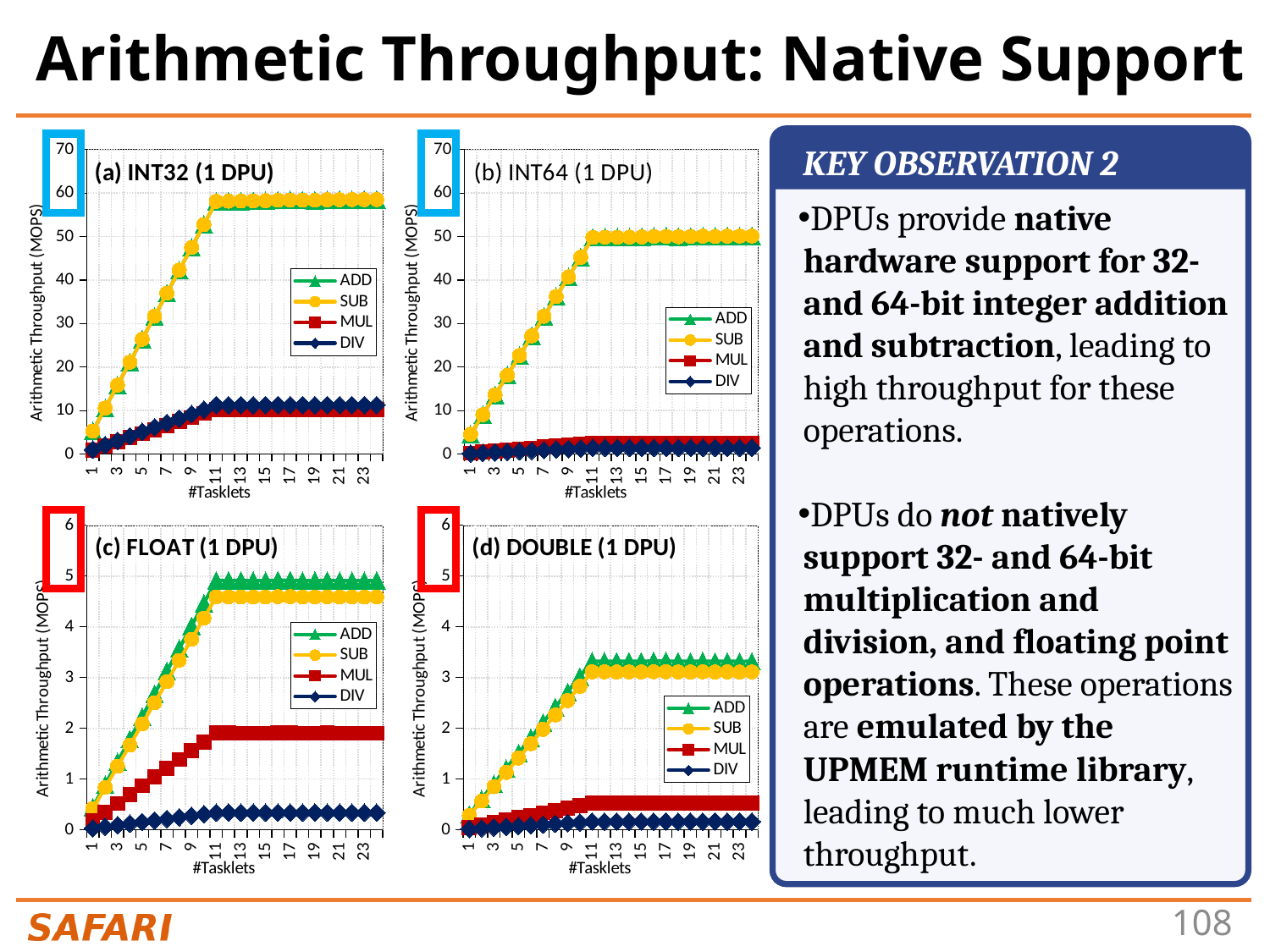
What kind of chart is chart (a) INT32 (1 DPU)? line chart In chart (c) FLOAT (1 DPU), which is larger at 23 tasklets, MUL or DIV? MUL In chart (b) INT64 (1 DPU), is the SUB throughput at 23 tasklets greater or less than 40? greater What is the x-axis label of chart (d) DOUBLE (1 DPU)? #Tasklets How many series does the legend of chart (b) INT64 (1 DPU) list? 4 In chart (a) INT32 (1 DPU), does the ADD throughput rise or fall as the number of tasklets increases from 1 to 11? rise In chart (c) FLOAT (1 DPU), which series has the lowest throughput at 23 tasklets? DIV In chart (a) INT32 (1 DPU), is the ADD throughput at 23 tasklets greater or less than 50? greater What are the legend entries in chart (c) FLOAT (1 DPU)? ADD, SUB, MUL, DIV How many charts are shown on the slide? 4 In chart (c) FLOAT (1 DPU), is the MUL throughput at 23 tasklets greater or less than 3? less